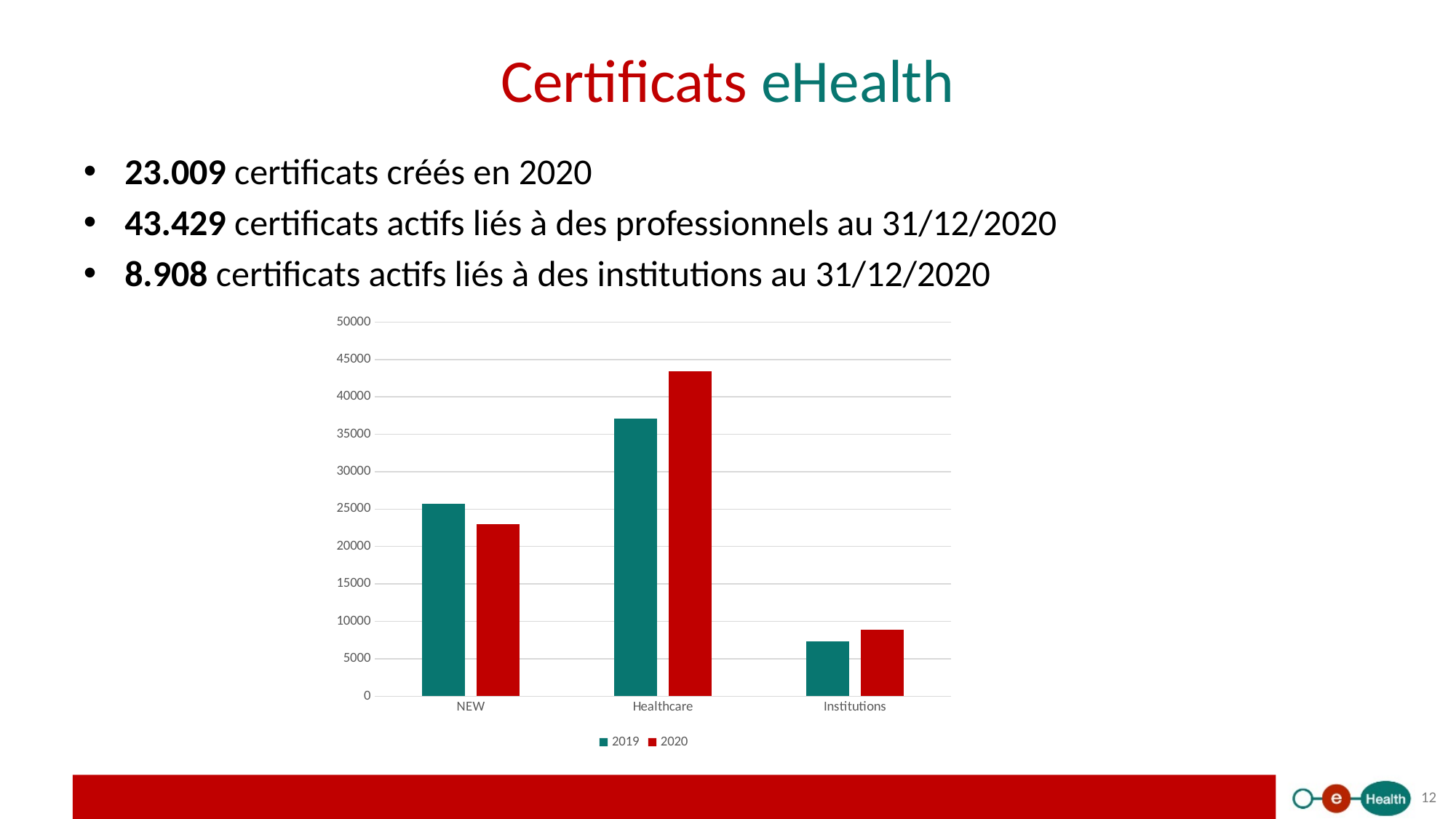
Is the 2020 value for NEW greater or less than 25000? less For the NEW category, which series has the larger value, 2019 or 2020? 2019 How many series does the chart's legend list? 2 How many categories are shown on the x axis of the chart? 3 Is the 2019 value for Institutions greater or less than 10000? less For the Institutions category, which series has the larger value, 2019 or 2020? 2020 Which colour represents the 2020 series in the chart? red Is the 2019 value for Healthcare greater or less than 35000? greater Which category has the lowest value for the 2019 series? Institutions What kind of chart is shown on the slide? bar chart Which category has the highest value for the 2020 series? Healthcare